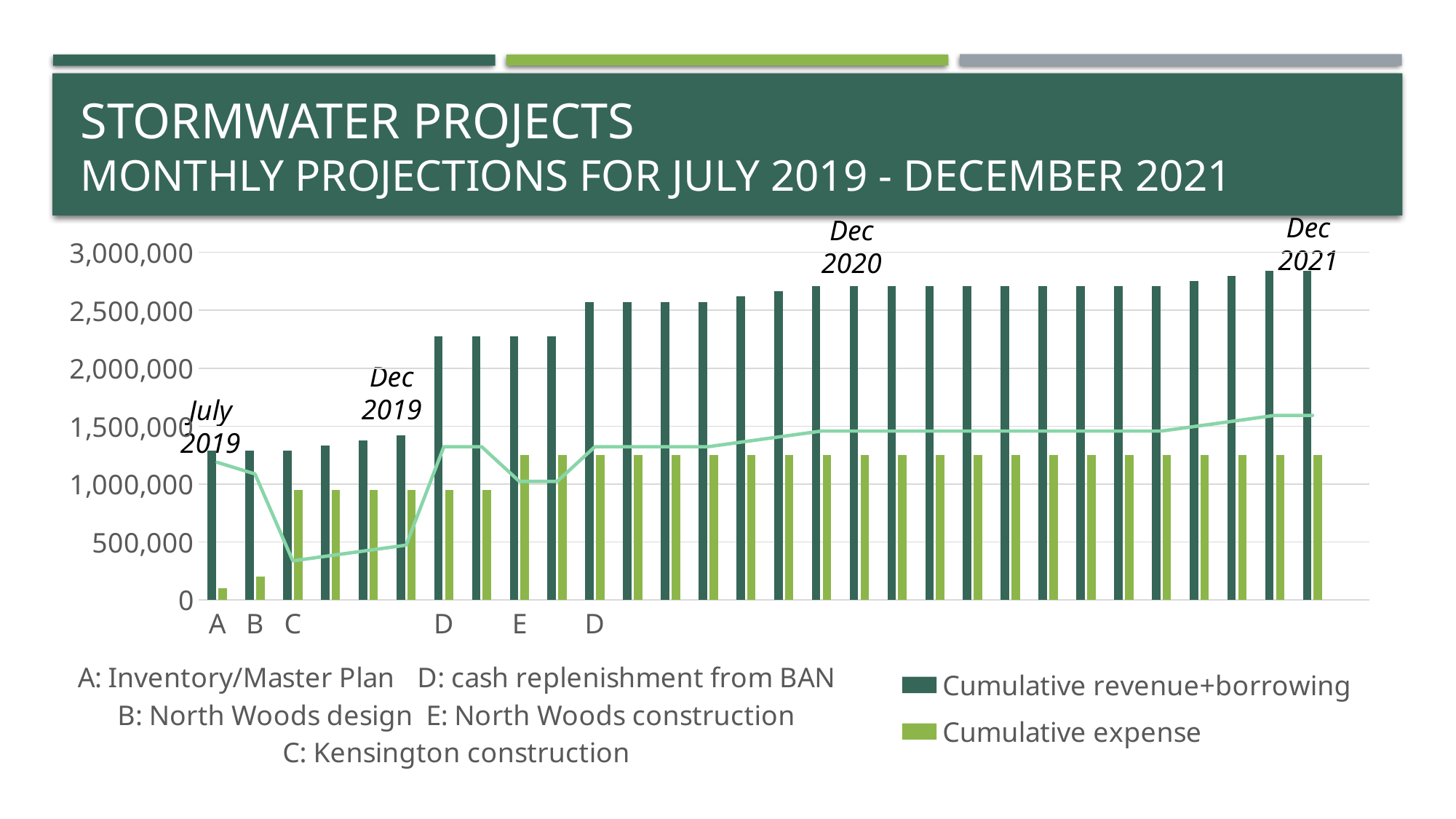
What kind of chart is used to show the cumulative revenue+borrowing and cumulative expense series? bar chart How many series does the legend list? 2 Is the cumulative revenue+borrowing for Dec 2021 greater or less than 2,500,000? greater In Dec 2021, which is larger: cumulative revenue+borrowing or cumulative expense? Cumulative revenue+borrowing Is the cumulative expense for Dec 2020 greater or less than 1,500,000? less What is the highest value shown on the vertical axis? 3,000,000 Is the cumulative revenue+borrowing for July 2019 greater or less than 1,500,000? less Does cumulative revenue+borrowing generally rise or fall from July 2019 to Dec 2021? rise Which month has the lowest cumulative expense? July 2019 What does the letter C on the x axis stand for? Kensington construction Which month has the highest cumulative revenue+borrowing? Dec 2021